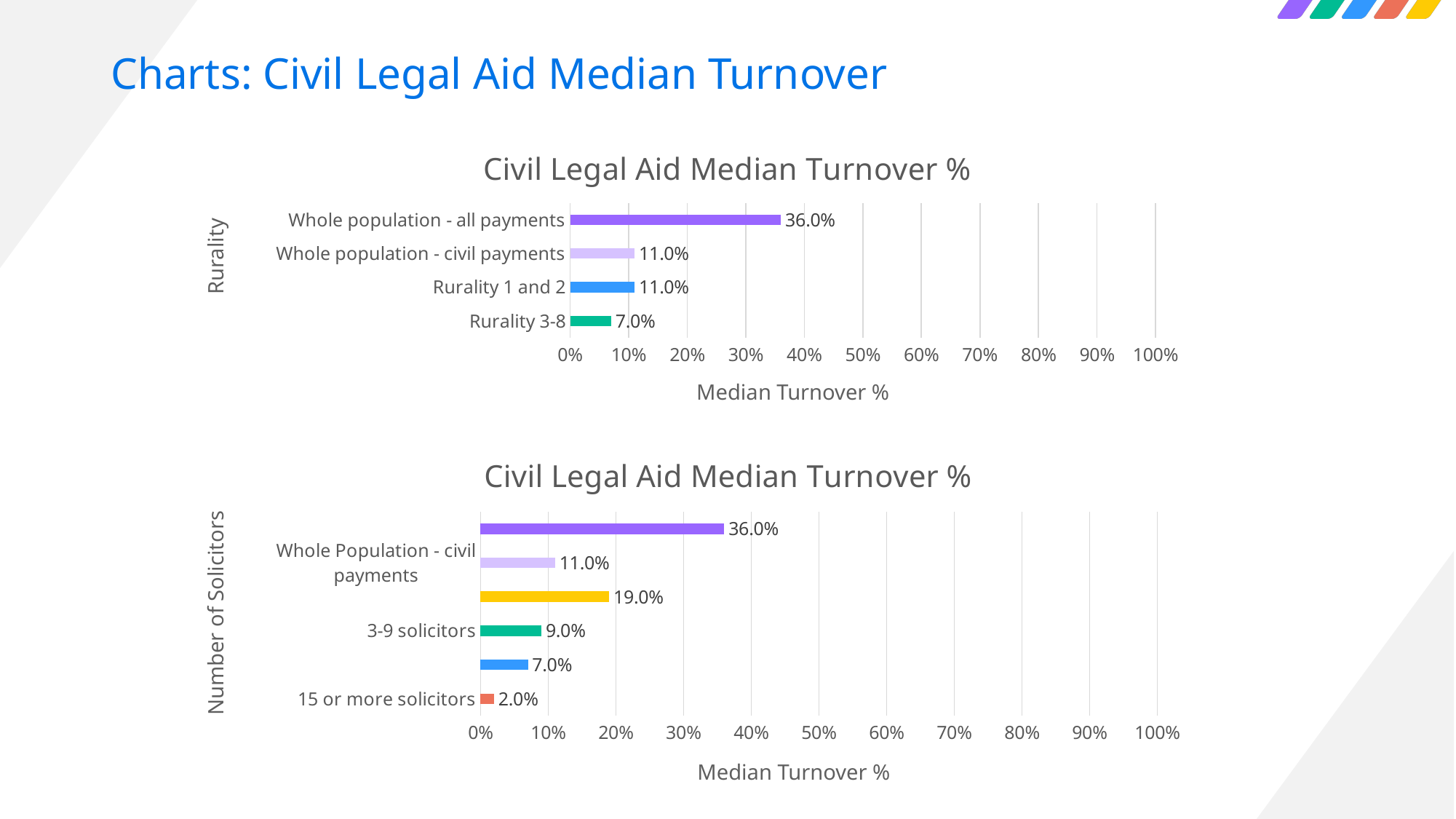
In the top chart (Rurality), what is the median turnover % for Rurality 3-8? 7.0% In the bottom chart (Number of Solicitors), how many bars are plotted? 6 In the bottom chart (Number of Solicitors), which labelled category has the lowest median turnover %? 15 or more solicitors In the top chart (Rurality), what is the median turnover % for Whole population - all payments? 36.0% In the top chart (Rurality), how many categories are plotted? 4 In the top chart (Rurality), which category has the highest median turnover %? Whole population - all payments In the bottom chart (Number of Solicitors), what is the median turnover % for 3-9 solicitors? 9.0% In the bottom chart (Number of Solicitors), which is larger: 3-9 solicitors or 15 or more solicitors? 3-9 solicitors In the top chart (Rurality), which category has the lowest median turnover %? Rurality 3-8 In the bottom chart (Number of Solicitors), what is the median turnover % for 15 or more solicitors? 2.0% What type of chart is the top chart on the slide? Bar chart In the top chart (Rurality), what is the difference between Whole population - all payments and Rurality 1 and 2? 25.0%